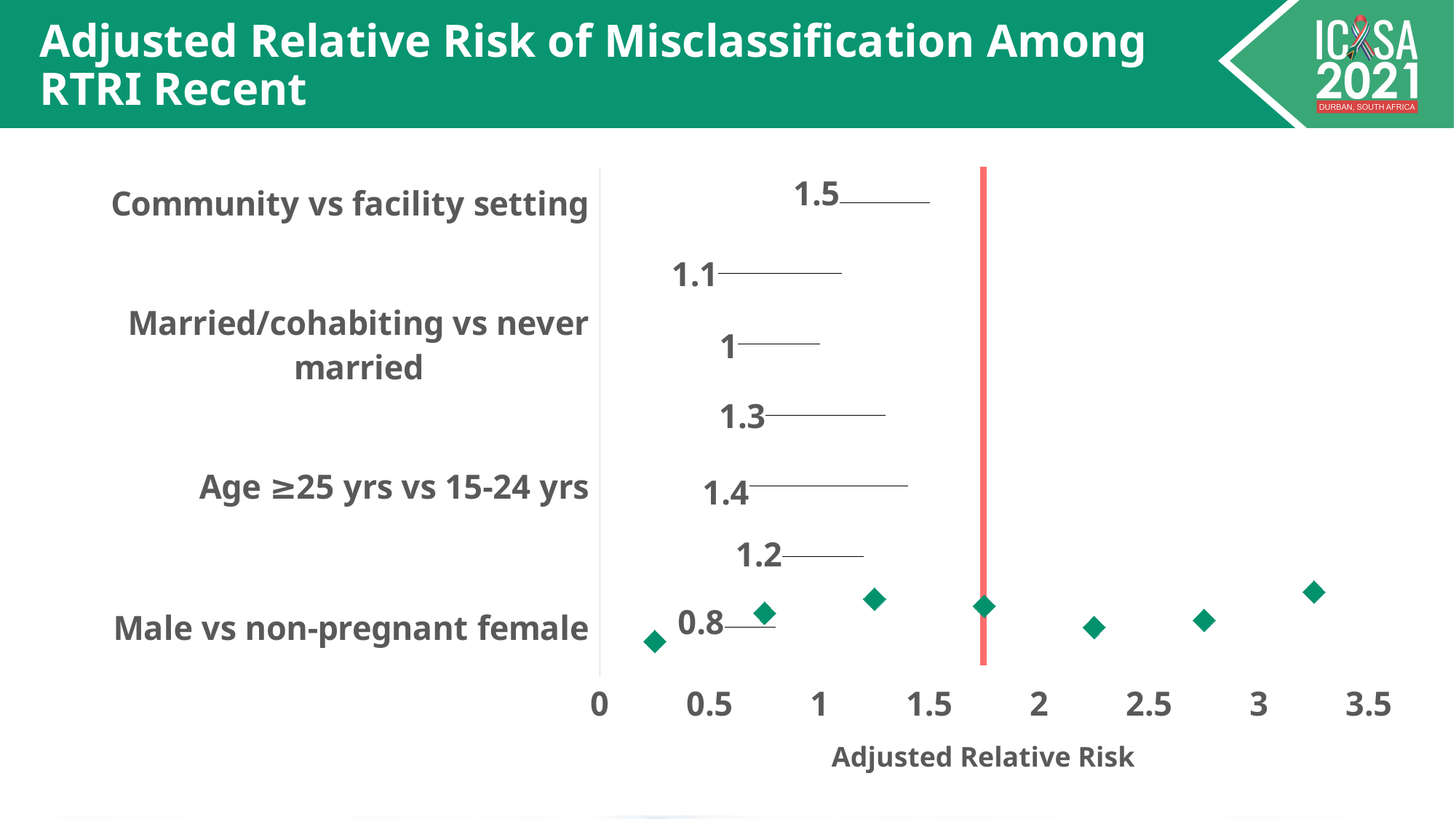
What is the title of the chart on the slide? Adjusted Relative Risk of Misclassification Among RTRI Recent What is the adjusted relative risk labelled for Community vs facility setting? 1.5 What is the adjusted relative risk labelled for Male vs non-pregnant female? 0.8 What is the highest adjusted relative risk value labelled on the chart? 1.5 How many comparison categories are labelled on the vertical axis of the chart? 4 Which has the larger labelled adjusted relative risk: Community vs facility setting or Male vs non-pregnant female? Community vs facility setting Is the labelled value for Community vs facility setting greater or less than 1? greater What is the lowest adjusted relative risk value labelled on the chart? 0.8 What is the label of the horizontal axis? Adjusted Relative Risk What is the maximum value shown on the horizontal axis? 3.5 What is the difference between the labelled values for Community vs facility setting and Male vs non-pregnant female? 0.7 Is the labelled value for Male vs non-pregnant female greater or less than 1? less